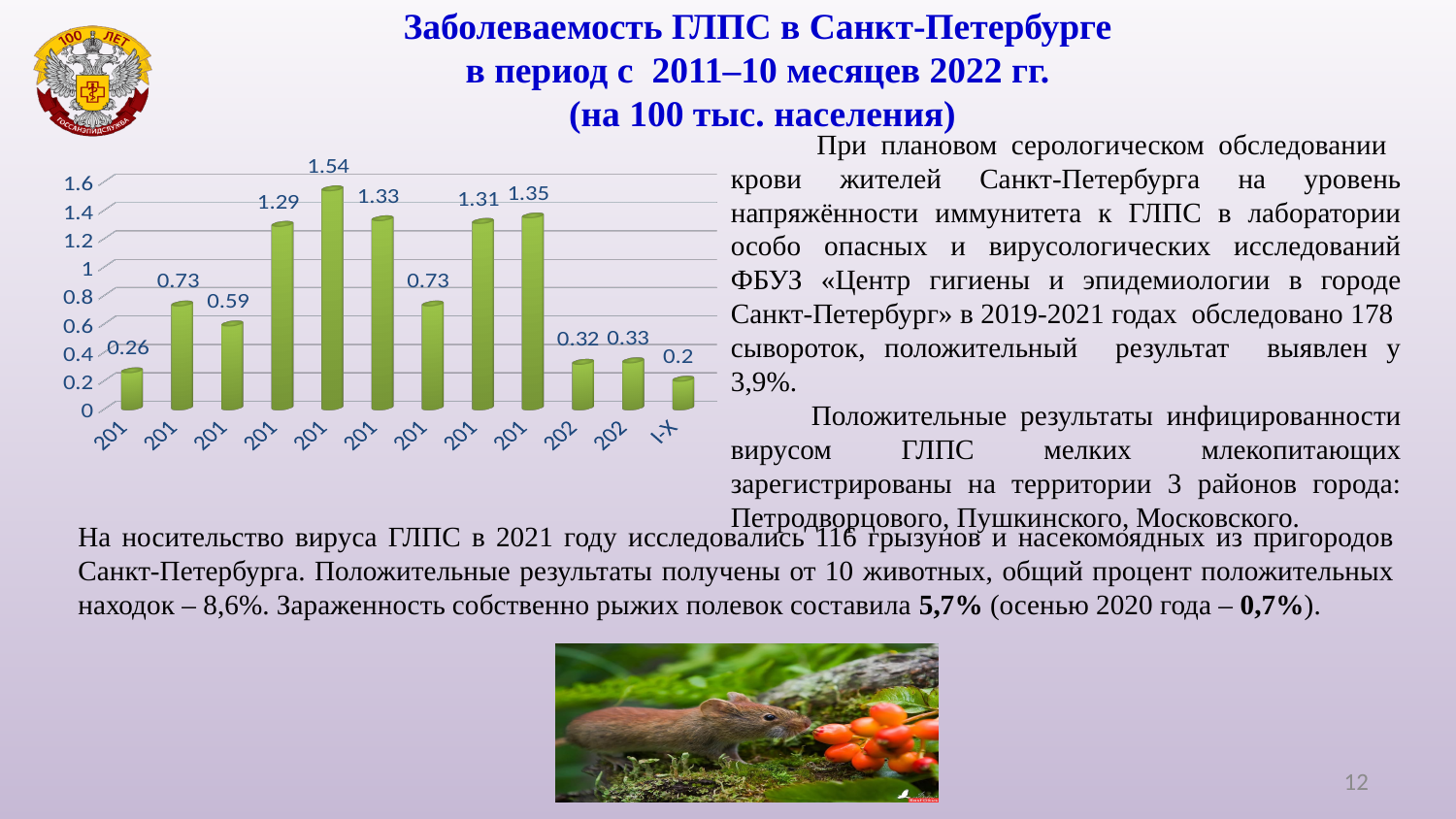
What is the difference between the second bar (0.73) and the first bar (0.26)? 0.47 What kind of chart is shown on the slide? bar chart What is the value of the last bar, labelled "I-X"? 0.2 How many bars does the chart contain? 12 What is the lowest value shown on the chart? 0.2 What colour are the bars on the chart? green Do the values rise or fall from the ninth bar (1.35) to the tenth bar (0.32)? fall What is the difference between the highest value (1.54) and the lowest value (0.2) on the chart? 1.34 What is the value of the first (leftmost) bar on the chart? 0.26 What is the highest value shown on the chart? 1.54 Is the value of the fifth bar greater or less than 1.4? greater Which is larger: the fourth bar (1.29) or the fifth bar (1.54)? the fifth bar (1.54)